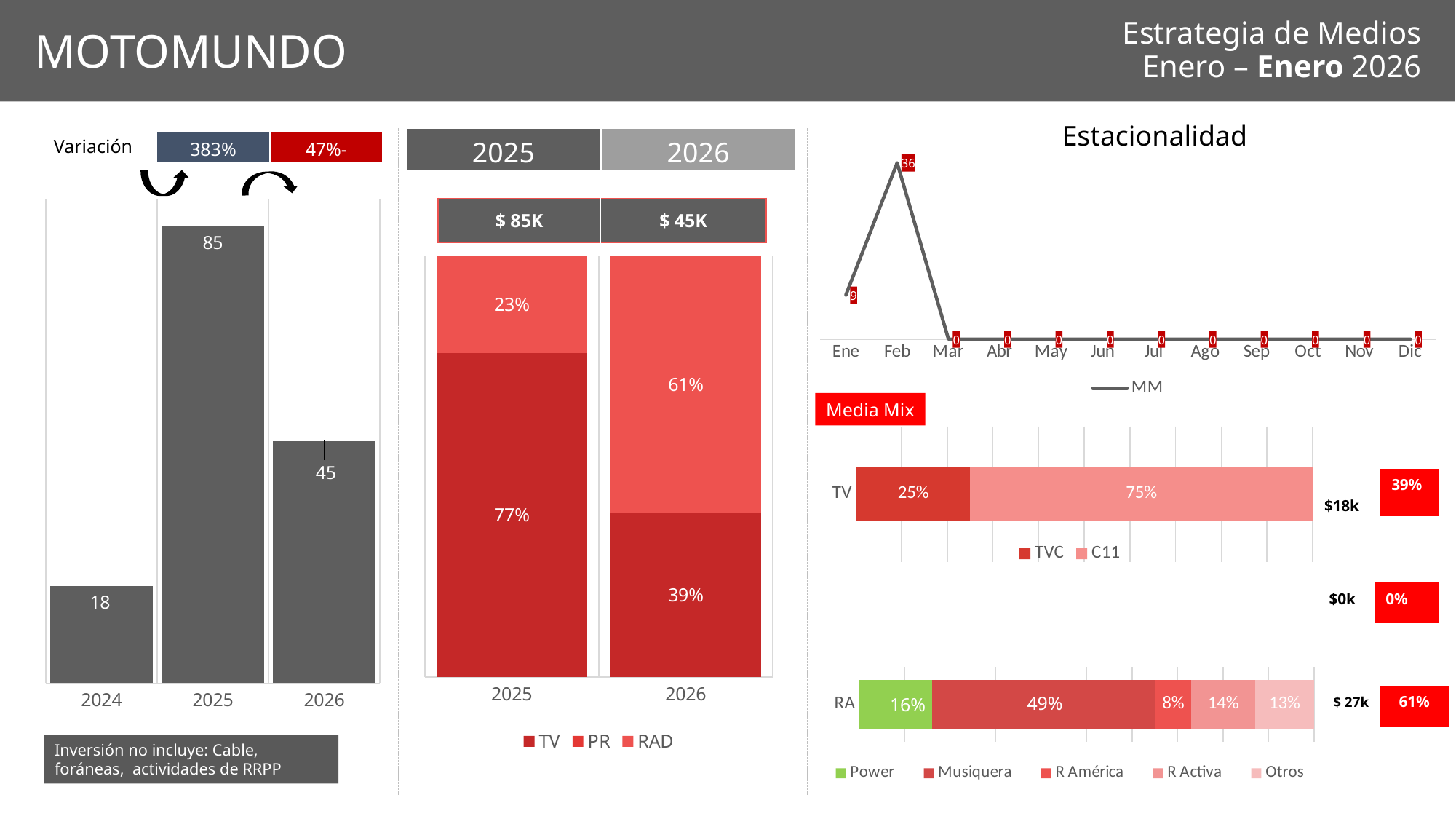
In the bar chart on the left, which year has the highest value? 2025 In the bar chart on the left, what is the value for 2025? 85 In the stacked bar chart in the middle, how many series does the legend list? 3 In the stacked bar chart in the middle, what percentage does TV represent in 2026? 39% In the bar chart on the left, what is the difference between the values for 2025 and 2026? 40 In the bar chart on the left, how many years are shown? 3 In the bar chart on the left, what is the value for 2024? 18 In the Estacionalidad line chart, which month has the highest value? Feb In the Media Mix chart, what percentage does C11 represent in the TV bar? 75% In the Estacionalidad line chart, what is the value for Feb? 36 In the stacked bar chart in the middle, what percentage does TV represent in 2025? 77% In the Media Mix chart, what percentage does Musiquera represent in the RA bar? 49%